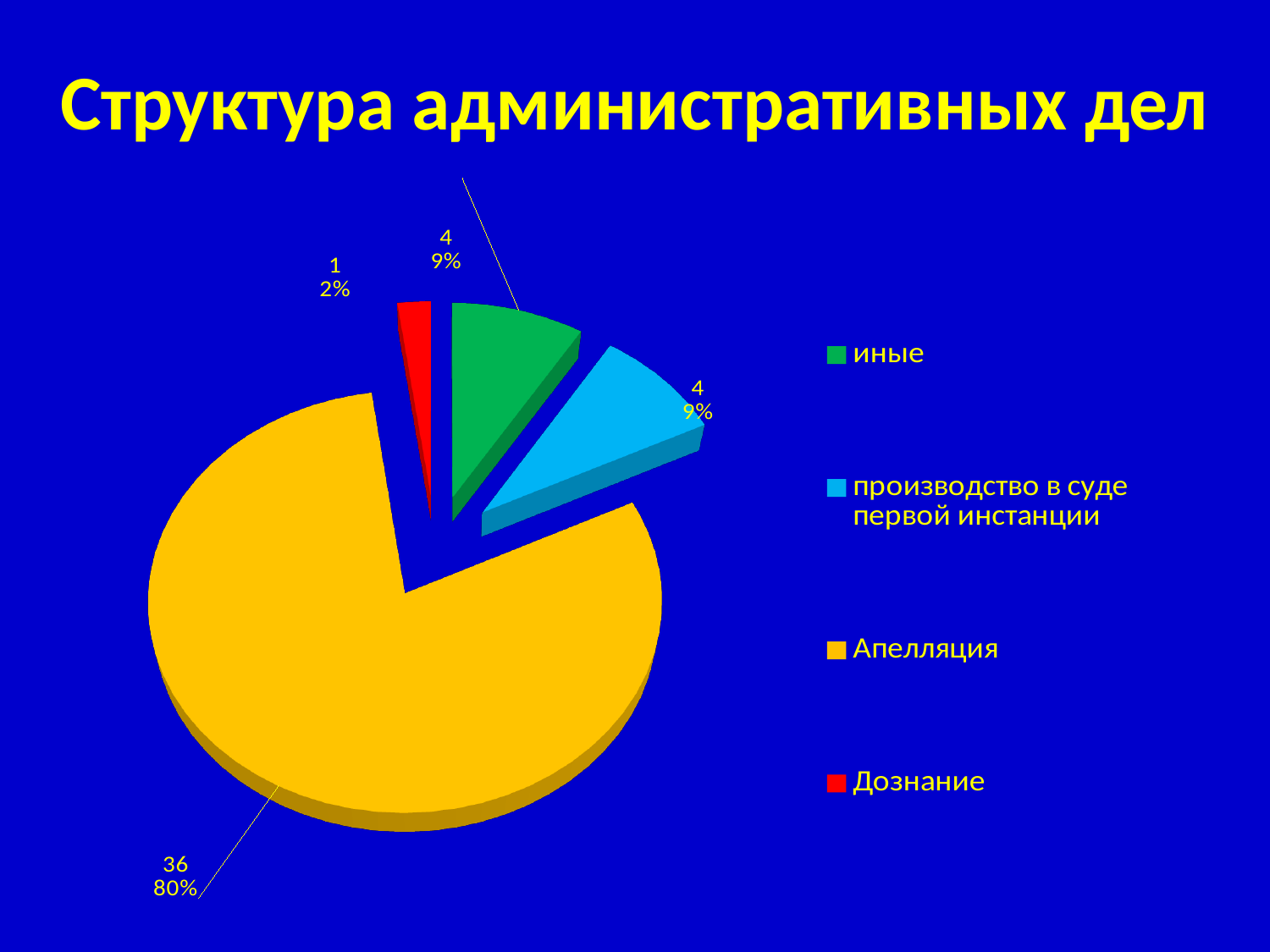
What share of the pie does производство в суде первой инстанции take? 9% How many entries does the legend list? 4 Which category has the smallest slice? Дознание What is the title of the chart? Структура административных дел What share of the pie does Апелляция take? 80% What kind of chart is shown on the slide? pie chart How many slices does the pie chart have? 4 Which category has the largest slice? Апелляция What is the value for Дознание? 1 What is the difference between the values for Апелляция and Дознание? 35 What is the value for иные? 4 What is the value for Апелляция? 36